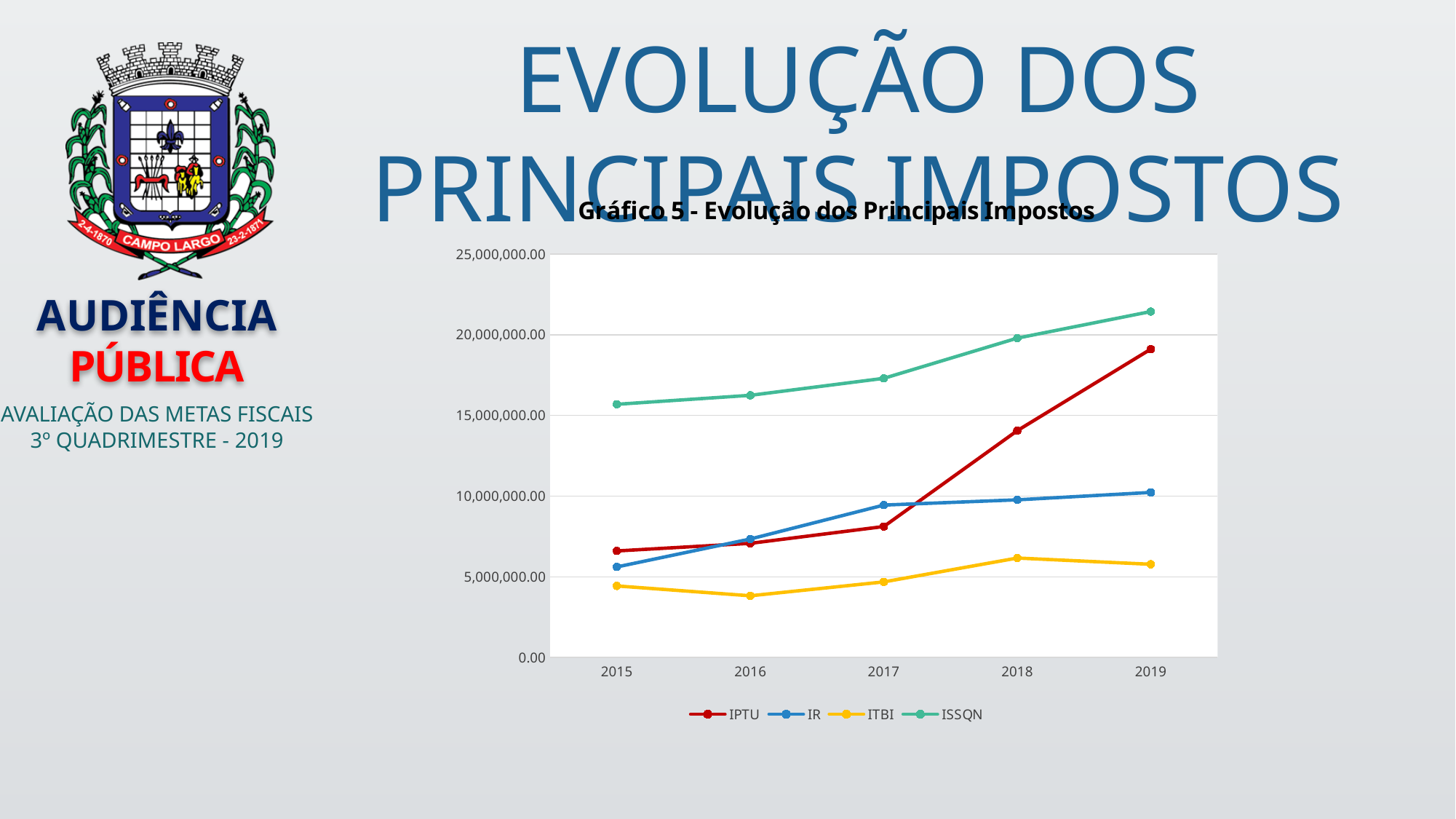
Which is larger in 2017, IR or IPTU? IR Is the value for IPTU in 2018 greater or less than 15,000,000.00? less What kind of chart is shown on the slide? line chart Which is larger in 2019, IPTU or IR? IPTU How many series does the legend list? 4 Which tax has the highest value in 2019? ISSQN Which tax has the lowest value in 2019? ITBI Is the value for ITBI in 2016 greater or less than 5,000,000.00? less Does the ISSQN line rise or fall from 2015 to 2019? rise What is the title of the chart? Gráfico 5 - Evolução dos Principais Impostos How many years are plotted along the x axis? 5 Is the value for ISSQN in 2019 greater or less than 20,000,000.00? greater